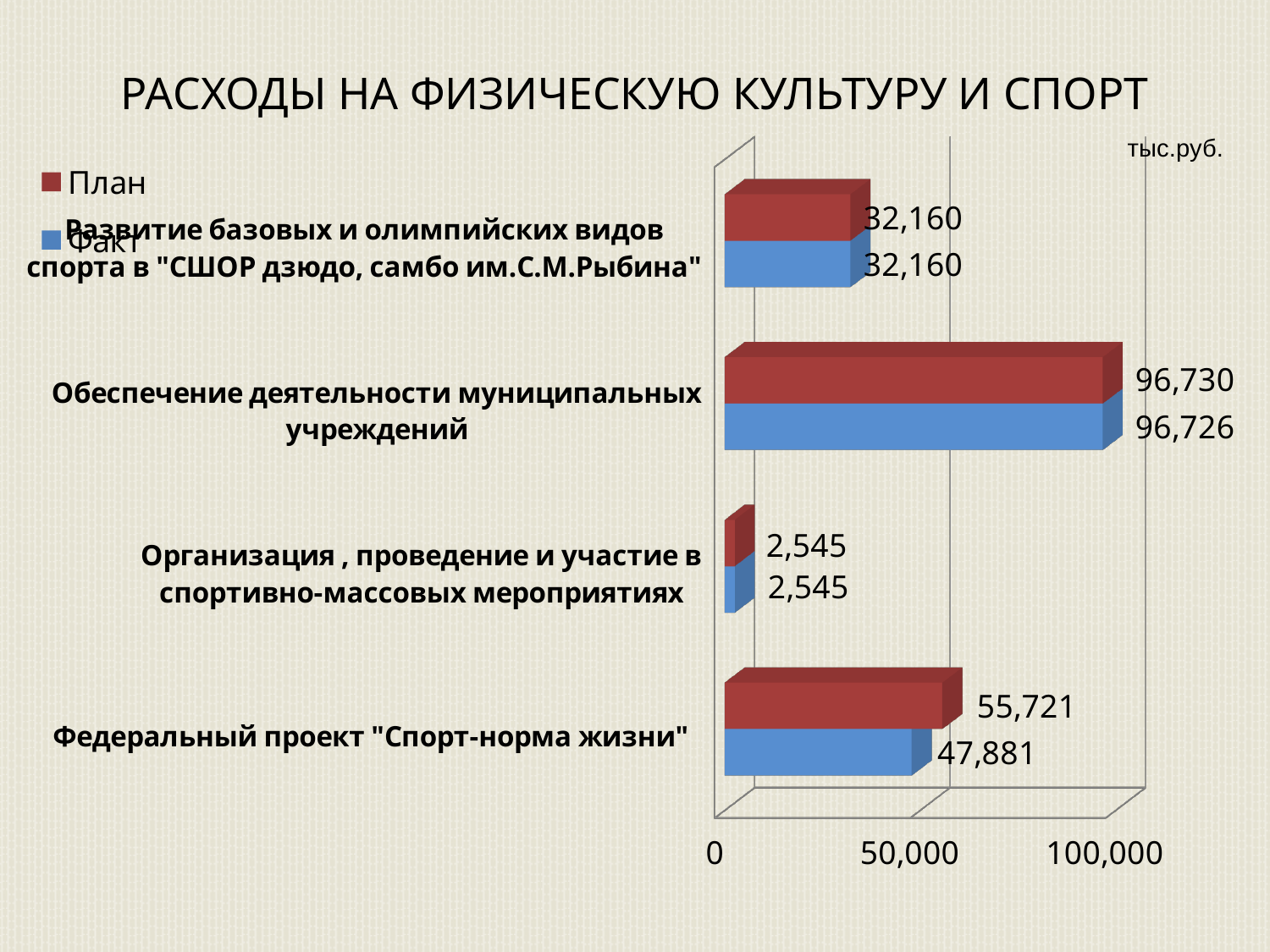
Is the План value for "Обеспечение деятельности муниципальных учреждений" greater or less than 50,000? greater What is the Факт value for "Федеральный проект "Спорт-норма жизни""? 47,881 What type of chart is shown on the slide? bar chart How many series does the legend list? 2 What is the Факт value for "Обеспечение деятельности муниципальных учреждений"? 96,726 Which category has the highest План value? Обеспечение деятельности муниципальных учреждений What is the difference between the План and Факт values for "Федеральный проект "Спорт-норма жизни""? 7,840 What is the План value for "Организация , проведение и участие в спортивно-массовых мероприятиях"? 2,545 What is the План value for "Федеральный проект "Спорт-норма жизни""? 55,721 How many categories are shown in the chart? 4 Which is larger for "Федеральный проект "Спорт-норма жизни"": the План value or the Факт value? План Which category has the lowest Факт value? Организация , проведение и участие в спортивно-массовых мероприятиях